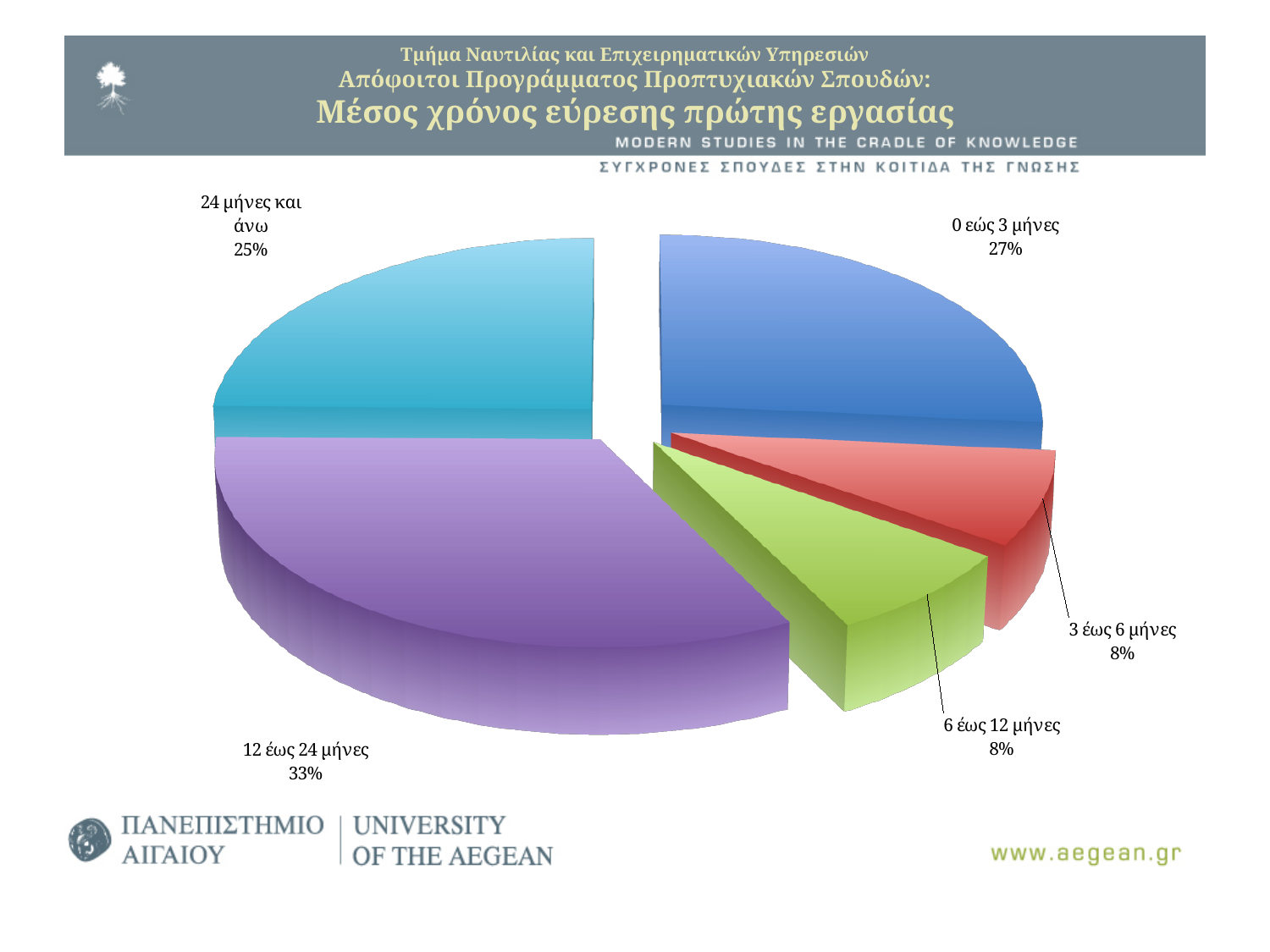
Which category has the largest share of the pie? 12 έως 24 μήνες What percentage is shown for "3 έως 6 μήνες"? 8% What share of the pie does the slice "24 μήνες και άνω" represent? 25% What percentage is shown for "6 έως 12 μήνες"? 8% What colour is the slice for "12 έως 24 μήνες"? Purple How many slices does the pie chart have? 5 What is the combined percentage of "3 έως 6 μήνες" and "6 έως 12 μήνες"? 16% What is the difference in percentage points between "12 έως 24 μήνες" and "0 εώς 3 μήνες"? 6 What kind of chart is shown on the slide? Pie chart What share of the pie does the slice "0 εώς 3 μήνες" represent? 27% Which is larger, the share for "0 εώς 3 μήνες" or the share for "24 μήνες και άνω"? 0 εώς 3 μήνες What share of the pie does the slice "12 έως 24 μήνες" represent? 33%